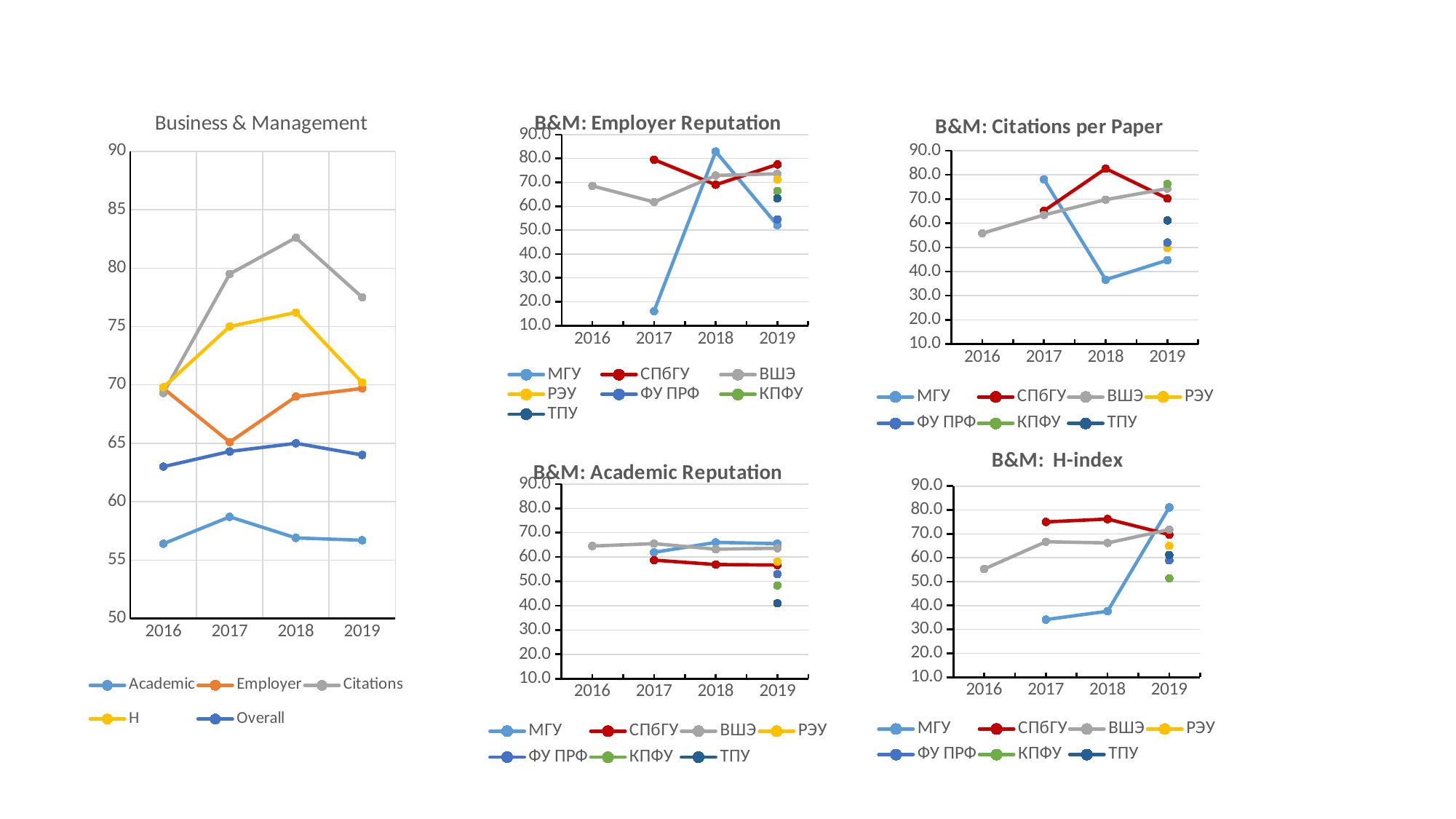
In the "Business & Management" chart, is the value for Employer in 2017 greater or less than 70? less What kind of chart is the "Business & Management" chart on the left of the slide? line chart In the "Business & Management" chart, which series has the highest value in 2018? Citations In the "B&M: Employer Reputation" chart, which series has the highest value in 2018? МГУ In the "Business & Management" chart, which series has the lowest value in 2019? Academic In the "Business & Management" chart, is the value for Citations in 2018 greater or less than 80? greater In the "B&M: Employer Reputation" chart, is the value for МГУ in 2017 greater or less than 20? less In the "B&M: Citations per Paper" chart, which is larger in 2018, СПбГУ or МГУ? СПбГУ How many years are shown on the x axis of the "B&M: Employer Reputation" chart? 4 In the "B&M: H-index" chart, does the МГУ line rise or fall from 2017 to 2019? rise How many series does the legend of the "Business & Management" chart list? 5 How many series does the legend of the "B&M: Citations per Paper" chart list? 7